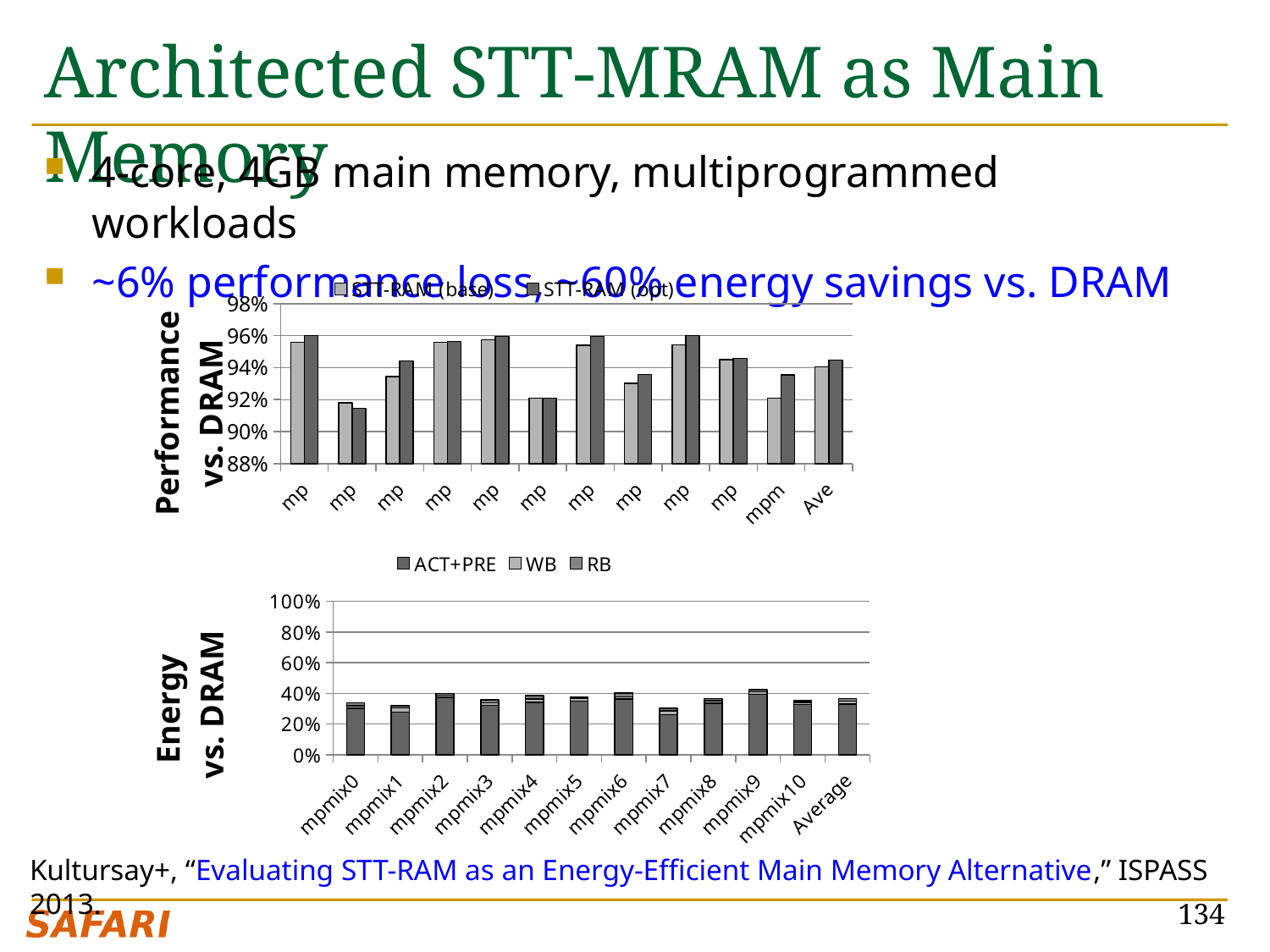
In the bottom chart (Energy vs. DRAM), is the total stacked value for mpmix7 greater or less than 40%? less In the top chart (Performance vs. DRAM), which series has the higher value for Ave, STT-RAM (base) or STT-RAM (opt)? STT-RAM (opt) In the bottom chart (Energy vs. DRAM), is the total stacked value for Average greater or less than 60%? less In the bottom chart (Energy vs. DRAM), which has the larger total stacked bar, mpmix7 or mpmix9? mpmix9 What are the legend entries of the bottom chart (Energy vs. DRAM)? ACT+PRE, WB, RB How many categories are shown on the x axis of the bottom chart (Energy vs. DRAM)? 12 What are the legend entries of the top chart (Performance vs. DRAM)? STT-RAM (base), STT-RAM (opt) How many series does the legend of the top chart (Performance vs. DRAM) list? 2 What kind of chart is the bottom chart (Energy vs. DRAM)? Stacked bar chart In the bottom chart (Energy vs. DRAM), which category has the lowest total stacked bar? mpmix7 In the top chart (Performance vs. DRAM), is the STT-RAM (opt) value for Ave greater or less than 92%? greater How many series does the legend of the bottom chart (Energy vs. DRAM) list? 3